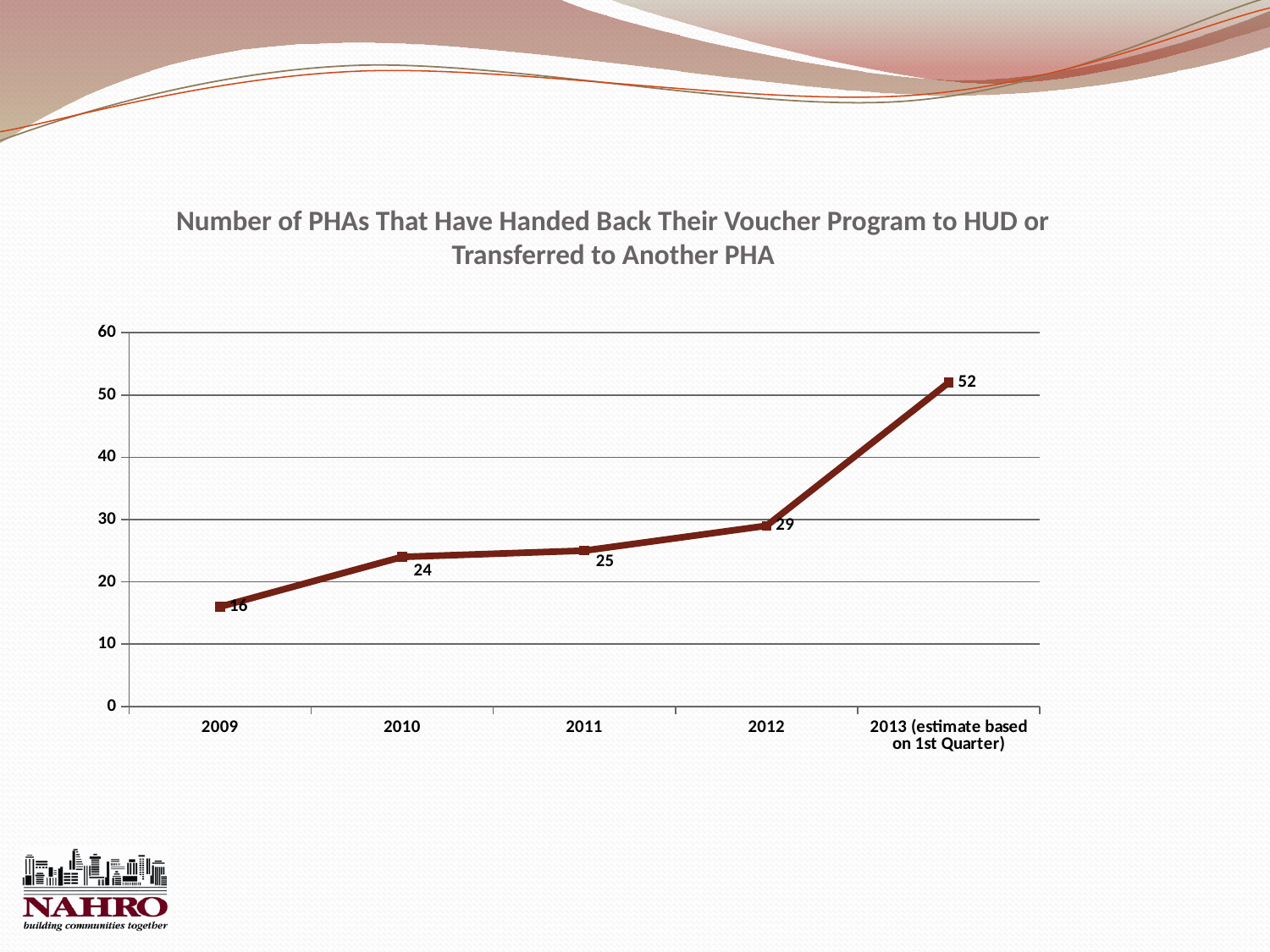
What is the difference between the values for 2013 (estimate based on 1st Quarter) and 2012? 23 Which year has the lowest value? 2009 How many data points are plotted on the chart? 5 What is the difference between the values for 2012 and 2010? 5 What is the value for 2011? 25 What kind of chart is shown on the slide? line chart Which is larger, the value for 2010 or the value for 2012? 2012 What is the value for 2009? 16 Do the values rise or fall from 2009 to 2013? rise Is the value for 2013 (estimate based on 1st Quarter) greater or less than 40? greater Which year has the highest value? 2013 (estimate based on 1st Quarter) What is the value for 2013 (estimate based on 1st Quarter)? 52